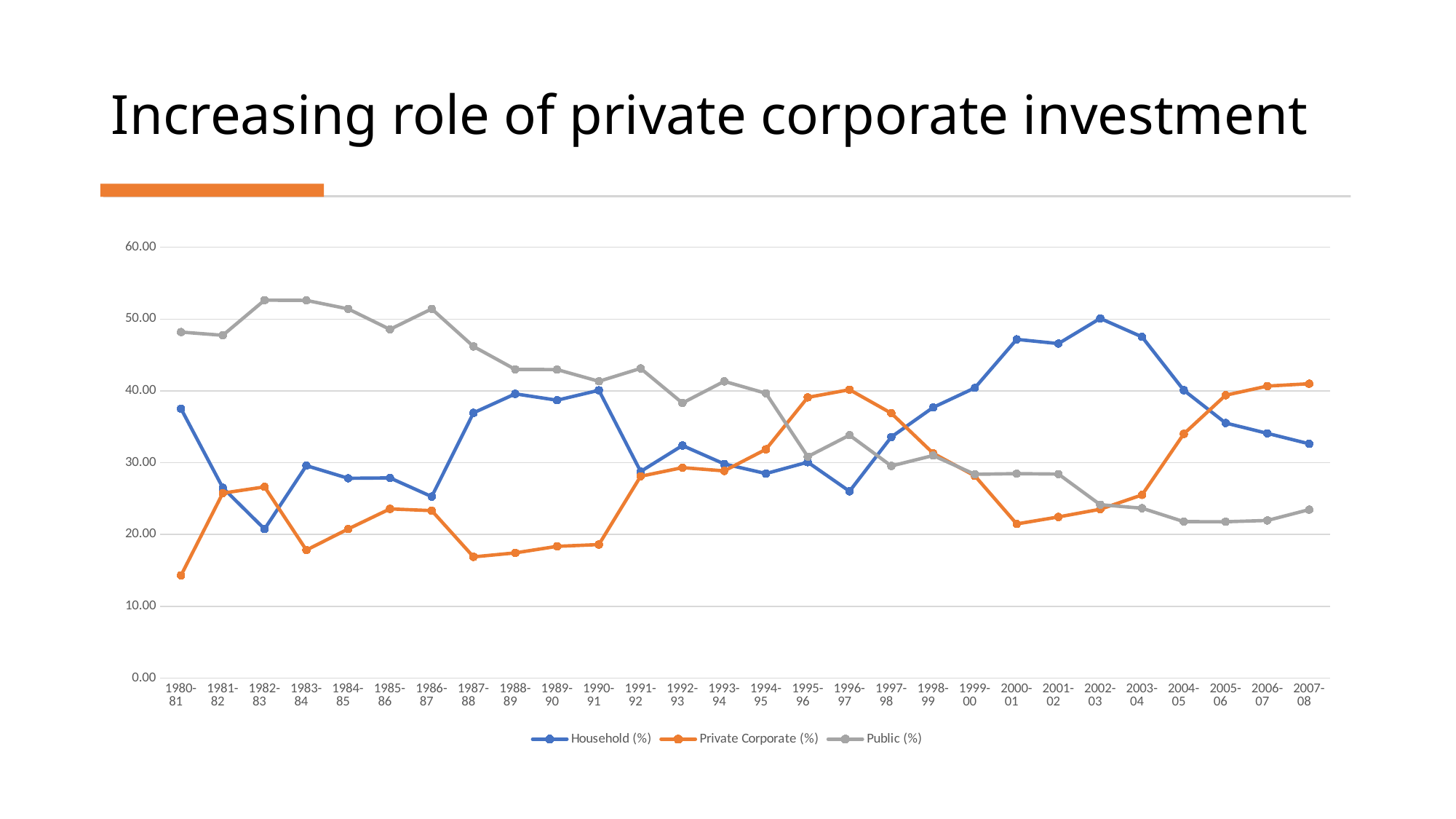
Which series has the highest value in 1985-86? Public (%) What kind of chart is shown on the slide? line chart How many fiscal years are plotted along the x axis? 28 Is the value for Public (%) in 1982-83 greater or less than 50? greater Is the value for Household (%) in 1996-97 greater or less than 30? less How many series does the legend list? 3 What is the title of the slide? Increasing role of private corporate investment In 1980-81, which is larger: Public (%) or Household (%)? Public (%) Which series has the lowest value in 1987-88? Private Corporate (%) In 2007-08, which is larger: Private Corporate (%) or Household (%)? Private Corporate (%) Is the value for Private Corporate (%) in 2007-08 greater or less than 30? greater